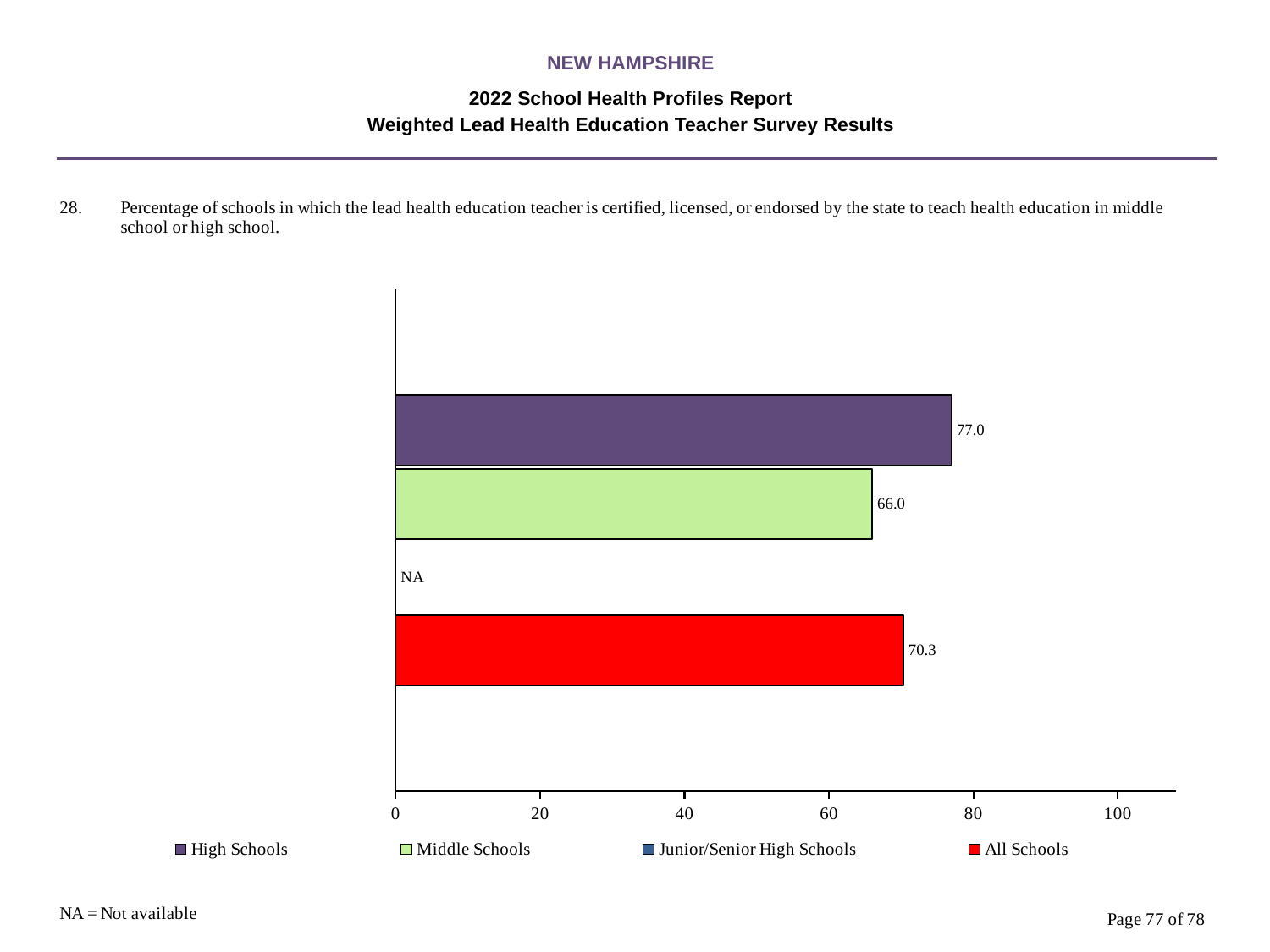
What is the difference between the High Schools value and the Middle Schools value? 11.0 Which series with a plotted value has the lowest value? Middle Schools How many series does the legend list? 4 What kind of chart is shown? bar chart What is the value for Middle Schools? 66.0 What colour is the All Schools bar? red Is the value for High Schools greater or less than 80? less What is shown for Junior/Senior High Schools? NA Which series has the highest value? High Schools What is the value for All Schools? 70.3 What is the value for High Schools? 77.0 Which is larger, the value for All Schools or the value for Middle Schools? All Schools